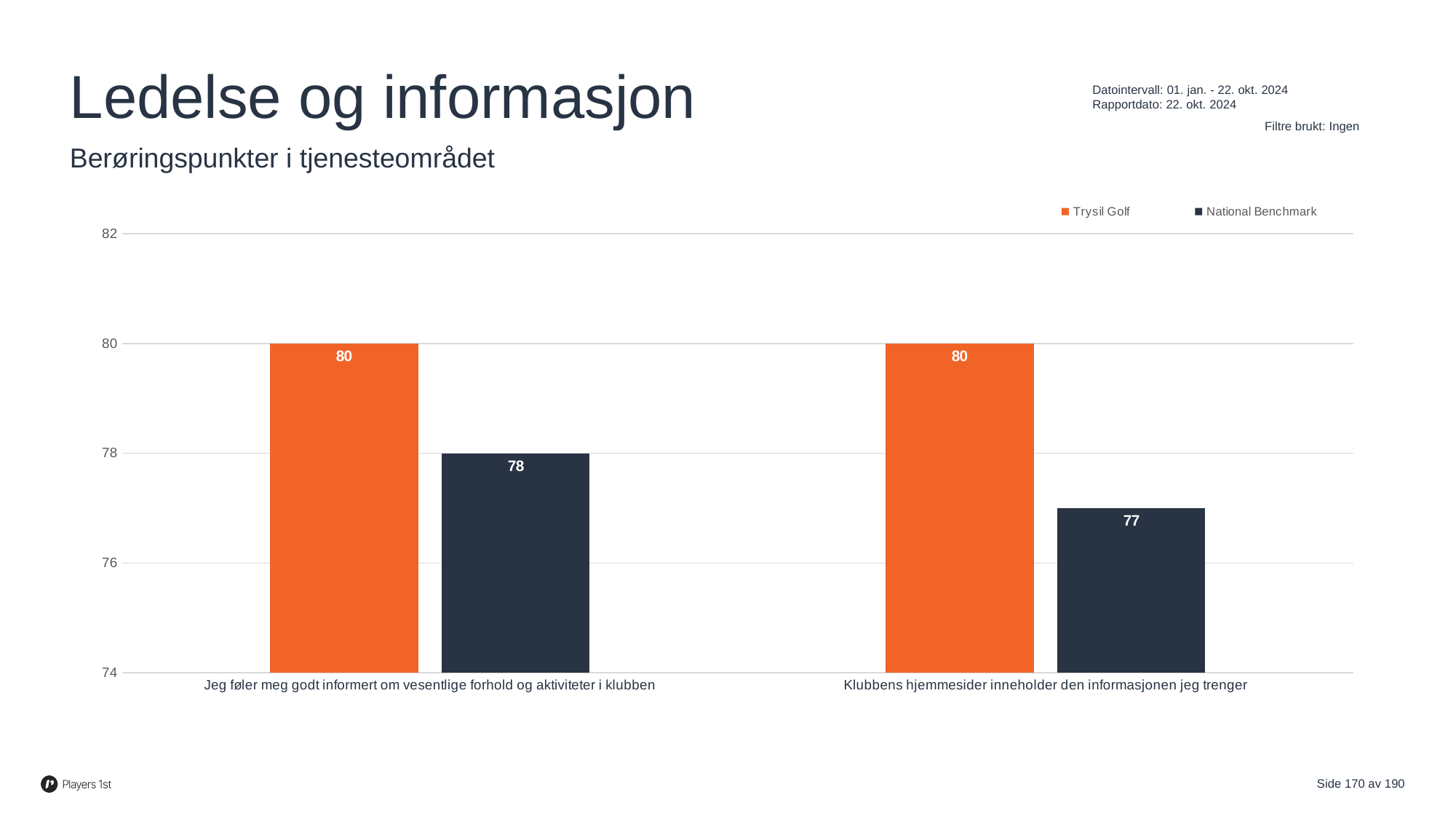
Is the National Benchmark value for "Klubbens hjemmesider inneholder den informasjonen jeg trenger" greater or less than 78? less How many categories are shown on the x axis? 2 What is the National Benchmark value for "Klubbens hjemmesider inneholder den informasjonen jeg trenger"? 77 Which category has the lowest National Benchmark value? Klubbens hjemmesider inneholder den informasjonen jeg trenger What kind of chart is shown on the slide? Bar chart For "Jeg føler meg godt informert om vesentlige forhold og aktiviteter i klubben", which is larger: Trysil Golf or National Benchmark? Trysil Golf What is the difference between the Trysil Golf and National Benchmark values for "Jeg føler meg godt informert om vesentlige forhold og aktiviteter i klubben"? 2 Which series is shown in orange? Trysil Golf What is the National Benchmark value for "Jeg føler meg godt informert om vesentlige forhold og aktiviteter i klubben"? 78 What is the Trysil Golf value for "Jeg føler meg godt informert om vesentlige forhold og aktiviteter i klubben"? 80 How many series does the legend list? 2 What is the difference between the Trysil Golf and National Benchmark values for "Klubbens hjemmesider inneholder den informasjonen jeg trenger"? 3